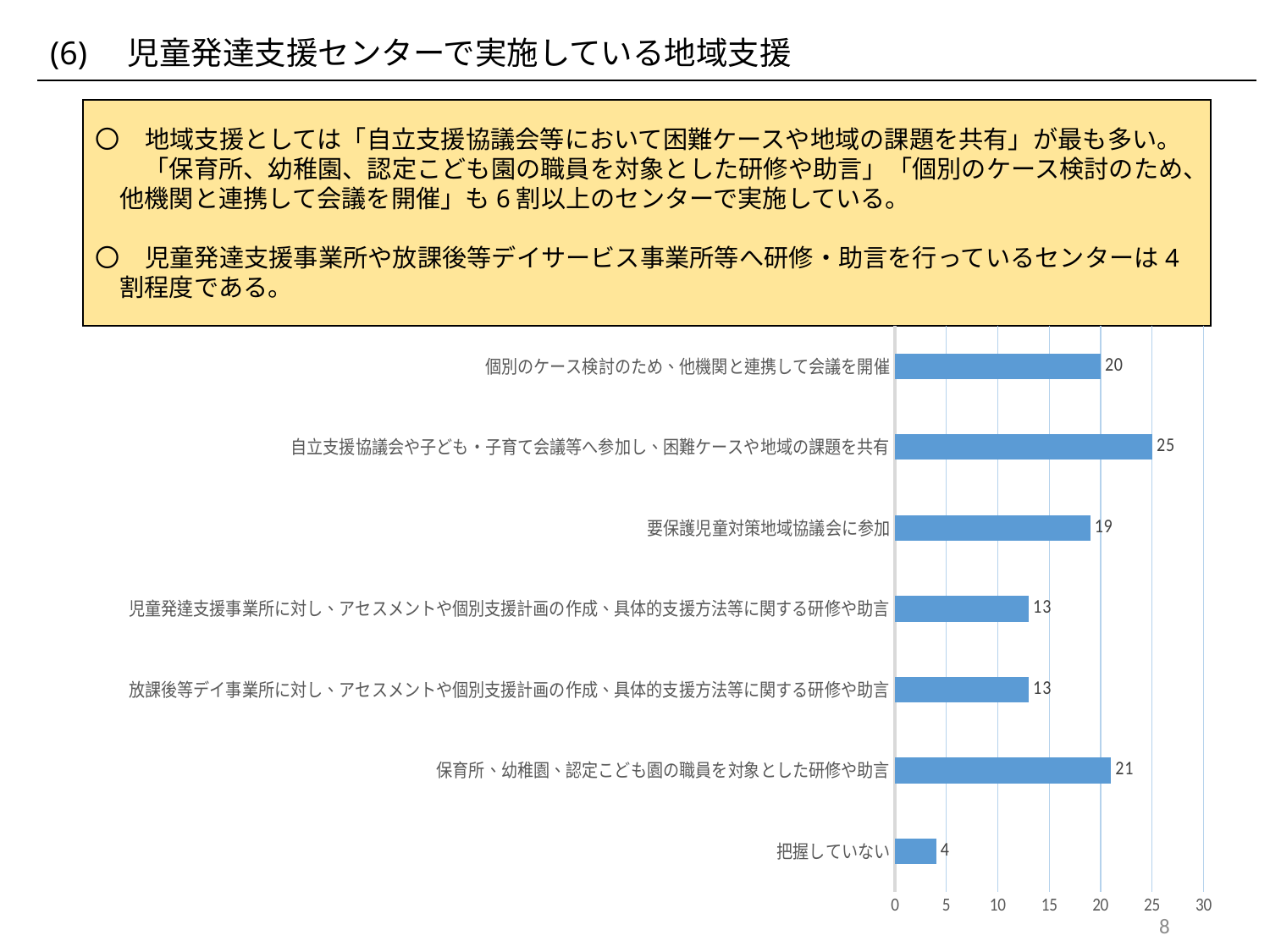
What kind of chart is shown on the slide? bar chart Which category has the highest value? 自立支援協議会や子ども・子育て会議等へ参加し、困難ケースや地域の課題を共有 What is the value for 「放課後等デイ事業所に対し、アセスメントや個別支援計画の作成、具体的支援方法等に関する研修や助言」? 13 What is the difference between the values for 「自立支援協議会や子ども・子育て会議等へ参加し、困難ケースや地域の課題を共有」 and 「保育所、幼稚園、認定こども園の職員を対象とした研修や助言」? 4 Which is larger: the value for 「個別のケース検討のため、他機関と連携して会議を開催」 or the value for 「要保護児童対策地域協議会に参加」? 個別のケース検討のため、他機関と連携して会議を開催 Which category has the lowest value? 把握していない What is the maximum value shown on the horizontal axis of the chart? 30 Is the value for 「保育所、幼稚園、認定こども園の職員を対象とした研修や助言」 greater or less than 15? greater How many categories are shown in the chart? 7 What is the value for 「把握していない」? 4 What is the value for 「要保護児童対策地域協議会に参加」? 19 What is the value for 「個別のケース検討のため、他機関と連携して会議を開催」? 20